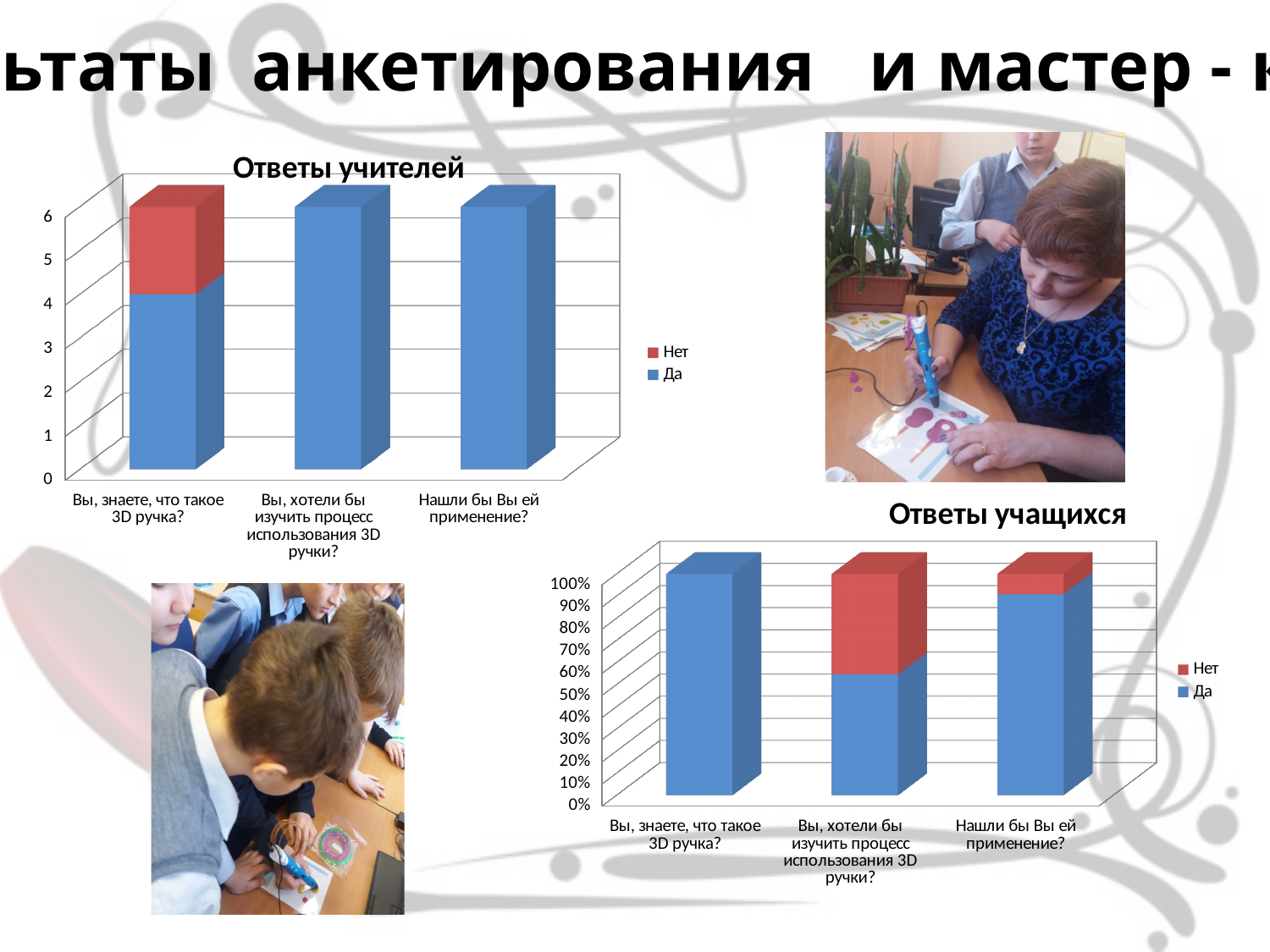
In the 'Ответы учащихся' chart, which colour represents 'Нет'? red How many series does the legend of the 'Ответы учащихся' chart list? 2 How many categories are shown on the x axis of the 'Ответы учителей' chart? 3 In the 'Ответы учителей' chart, which category is the only one with a 'Нет' segment? Вы, знаете, что такое 3D ручка? What kind of chart is the 'Ответы учителей' chart? bar chart In the 'Ответы учителей' chart, is the 'Да' value for 'Вы, знаете, что такое 3D ручка?' greater or less than 5? less In the 'Ответы учащихся' chart, which category has the largest 'Нет' share? Вы, хотели бы изучить процесс использования 3D ручки? In the 'Ответы учителей' chart, which category has the lowest 'Да' value? Вы, знаете, что такое 3D ручка? In the 'Ответы учащихся' chart, is the 'Нет' share for 'Нашли бы Вы ей применение?' greater or less than 20%? less In the 'Ответы учителей' chart, is the 'Да' value for 'Нашли бы Вы ей применение?' greater or less than 5? greater In the 'Ответы учащихся' chart, which category has the highest 'Да' share? Вы, знаете, что такое 3D ручка?